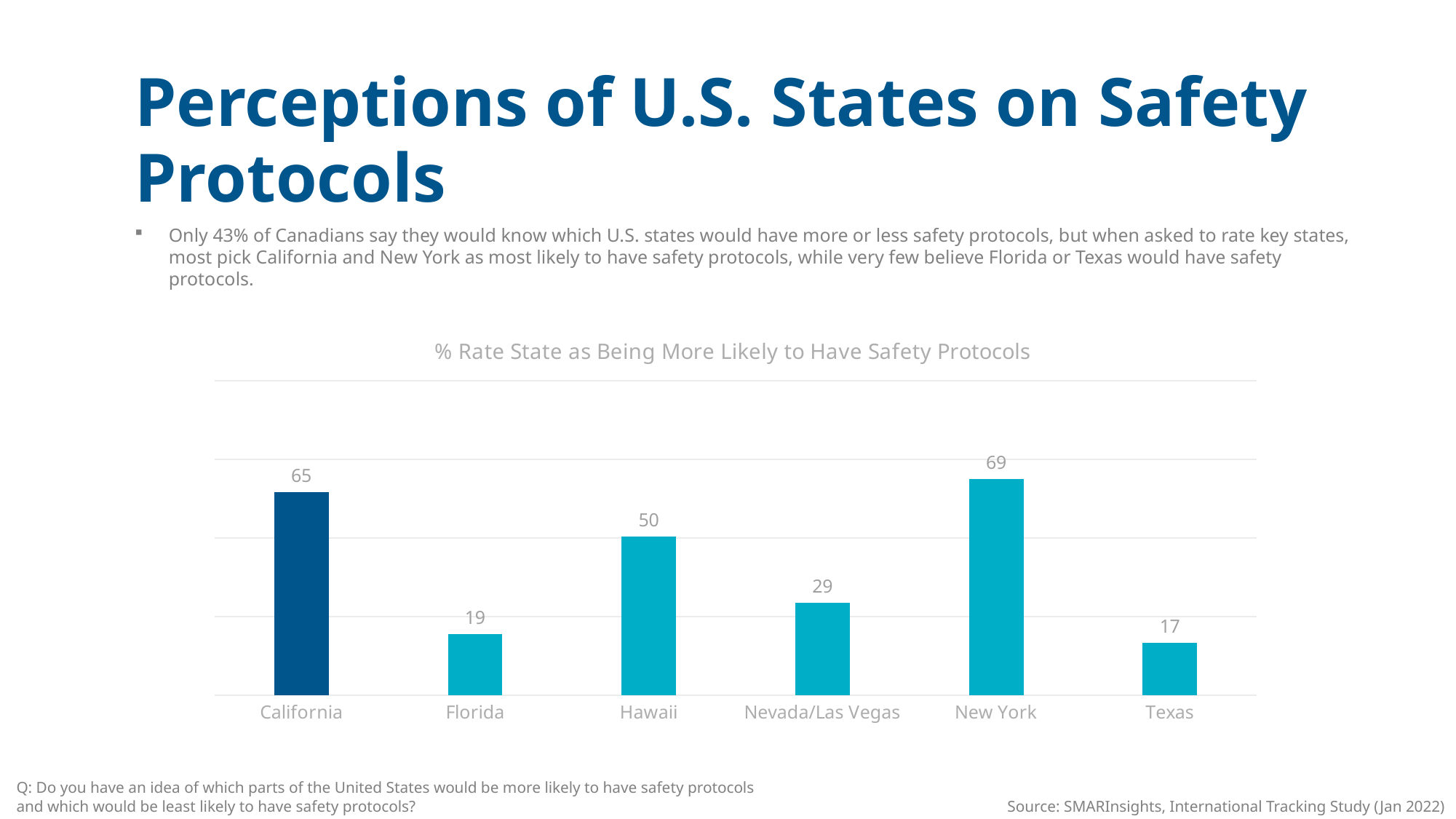
How many states are shown on the chart? 6 What is the value for Nevada/Las Vegas? 29 What is the difference between the values for Hawaii and Florida? 31 What is the value for California? 65 What kind of chart is shown on the slide? Bar chart Which bar is shown in a darker blue than the others? California Which state has the highest value? New York What is the value for Texas? 17 Which state has the lowest value? Texas What is the title of the chart? % Rate State as Being More Likely to Have Safety Protocols Which has a larger value, Hawaii or Nevada/Las Vegas? Hawaii What is the difference between the values for New York and California? 4